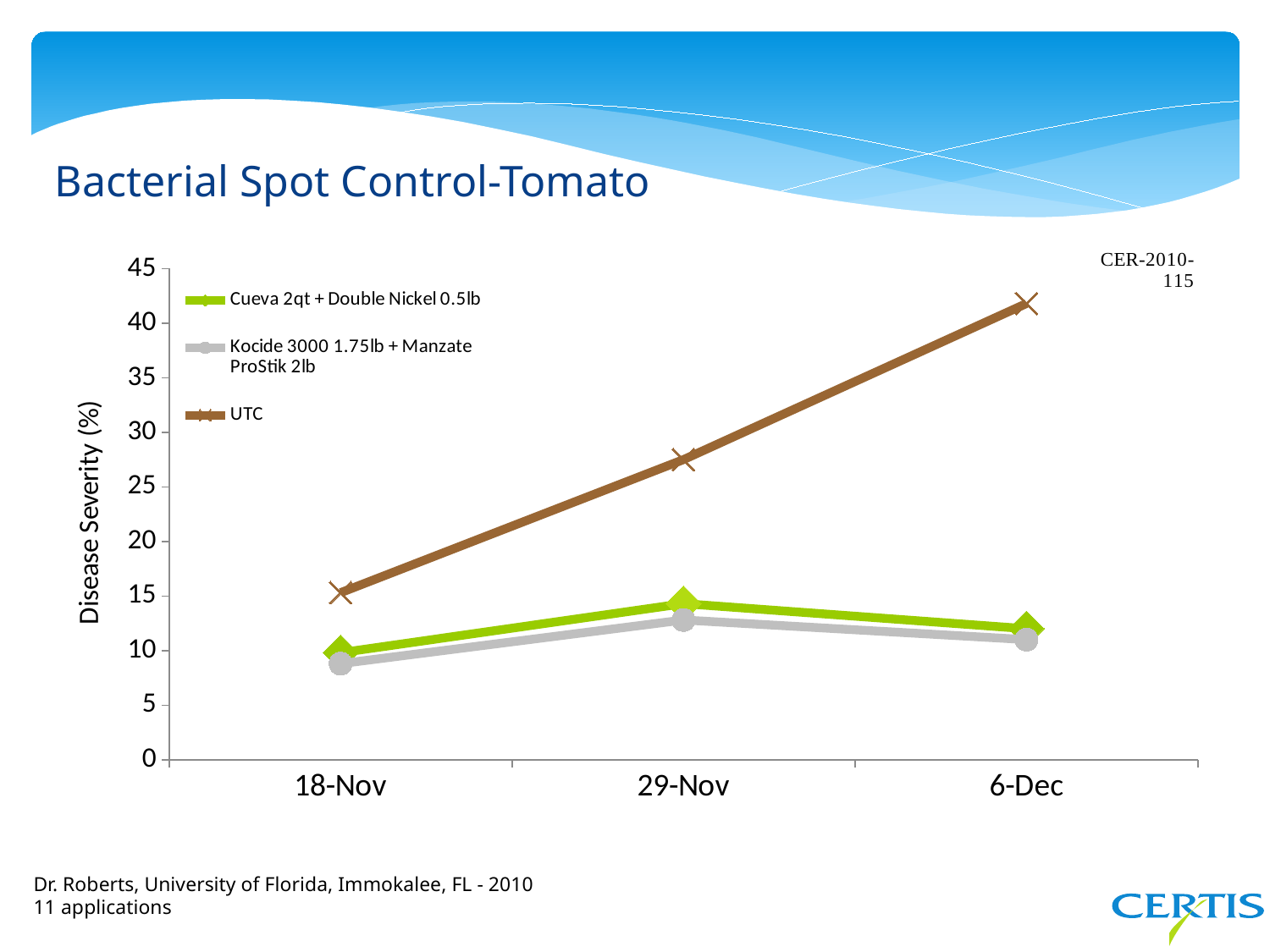
What is the title of the chart slide? Bacterial Spot Control-Tomato Is the UTC value on 6-Dec greater or less than 40? greater Is the UTC value on 29-Nov greater or less than 25? greater Is the UTC value on 18-Nov greater or less than 20? less On 29-Nov, which is larger: the UTC value or the Kocide 3000 1.75lb + Manzate ProStik 2lb value? UTC What kind of chart is shown on the slide? line chart Which series has the highest disease severity on 6-Dec? UTC How many series does the legend list? 3 What is the title of the y axis? Disease Severity (%) Does the UTC line rise or fall from 18-Nov to 6-Dec? rise How many dates are plotted along the x axis? 3